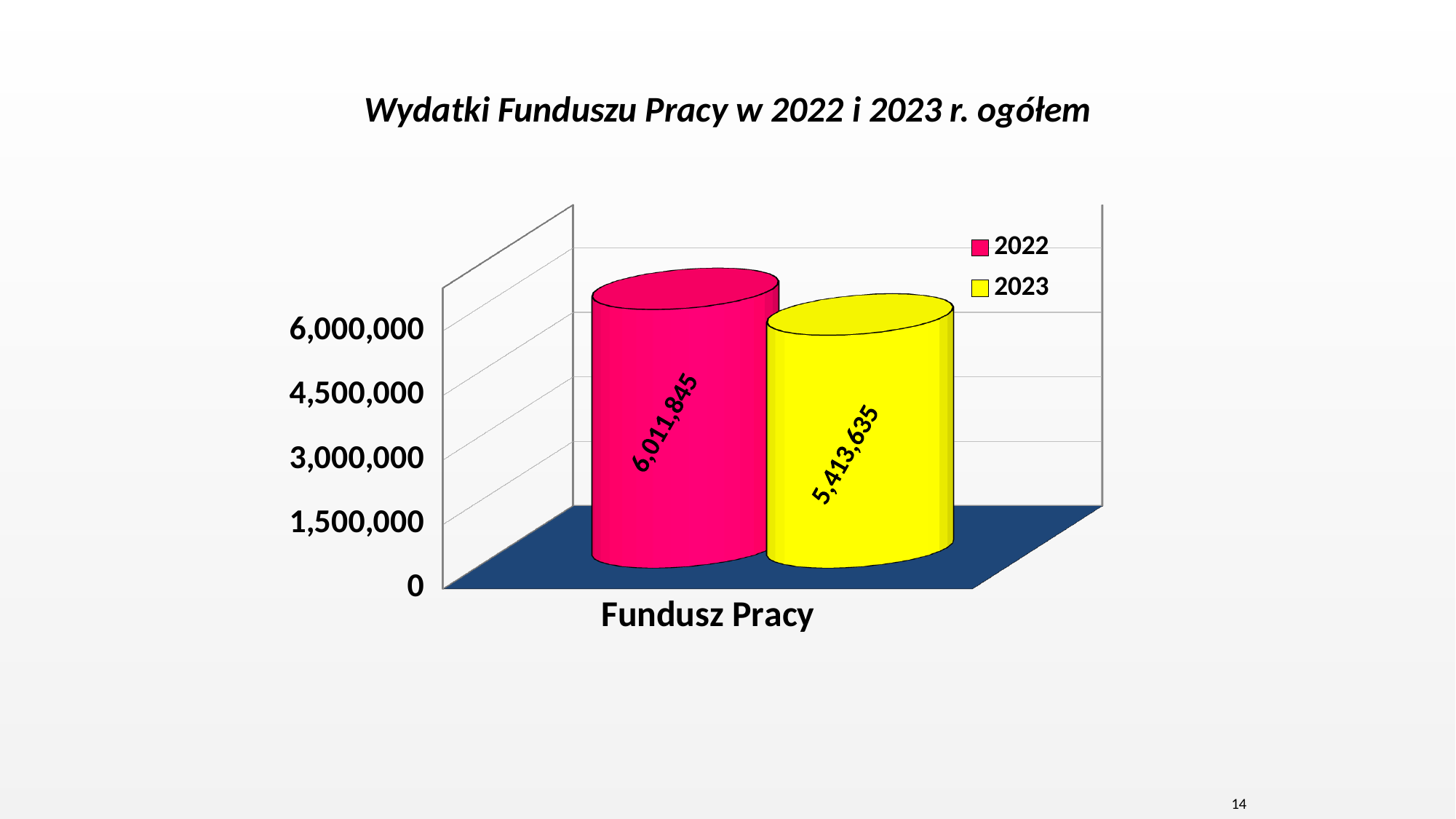
What is the value for 2022 in the chart? 6,011,845 What is the title of the chart? Wydatki Funduszu Pracy w 2022 i 2023 r. ogółem Which series has the lowest value in the chart? 2023 How many series does the legend list? 2 What kind of chart is shown on the slide? bar chart Which year has the higher value, 2022 or 2023? 2022 What is the category label shown on the x axis? Fundusz Pracy Which series has the highest value in the chart? 2022 What is the difference between the 2022 value and the 2023 value? 598,210 Is the value for 2022 greater or less than 4,500,000? greater Is the value for 2023 greater or less than 6,000,000? less What is the value for 2023 in the chart? 5,413,635